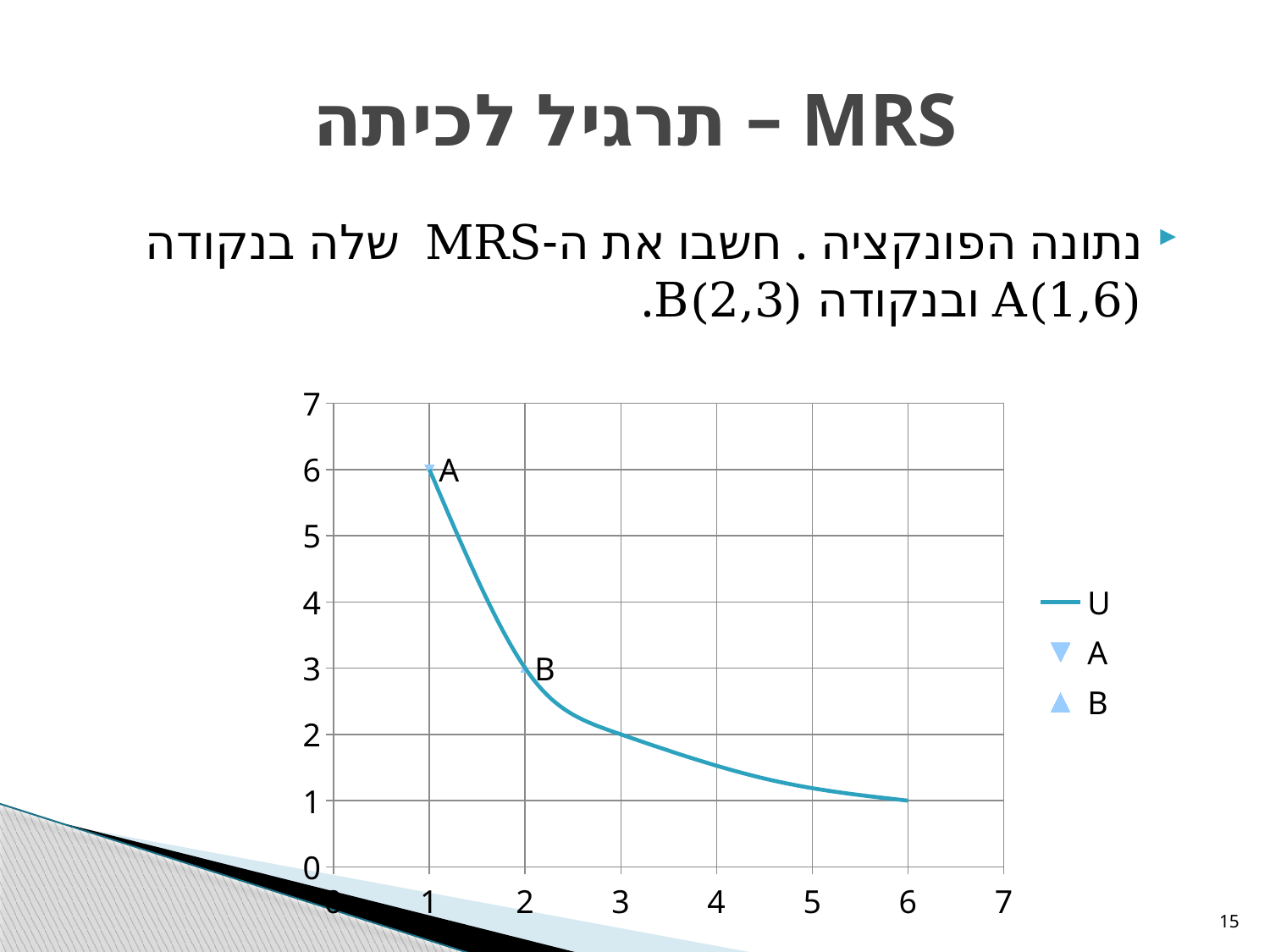
What is the y value of point A on the chart? 6 What is the x value of point B on the chart? 2 Is the y value of curve U at x = 4 greater or less than 2? less What is the x value of point A on the chart? 1 What are the entries in the chart legend? U, A, B What kind of chart is shown on the slide? line chart What is the highest value shown on the y axis? 7 What is the difference between the y values of points A and B? 3 What is the y value of point B on the chart? 3 How many series does the chart legend list? 3 Does the curve U rise or fall as x increases? fall Which labelled point has the higher y value, A or B? A